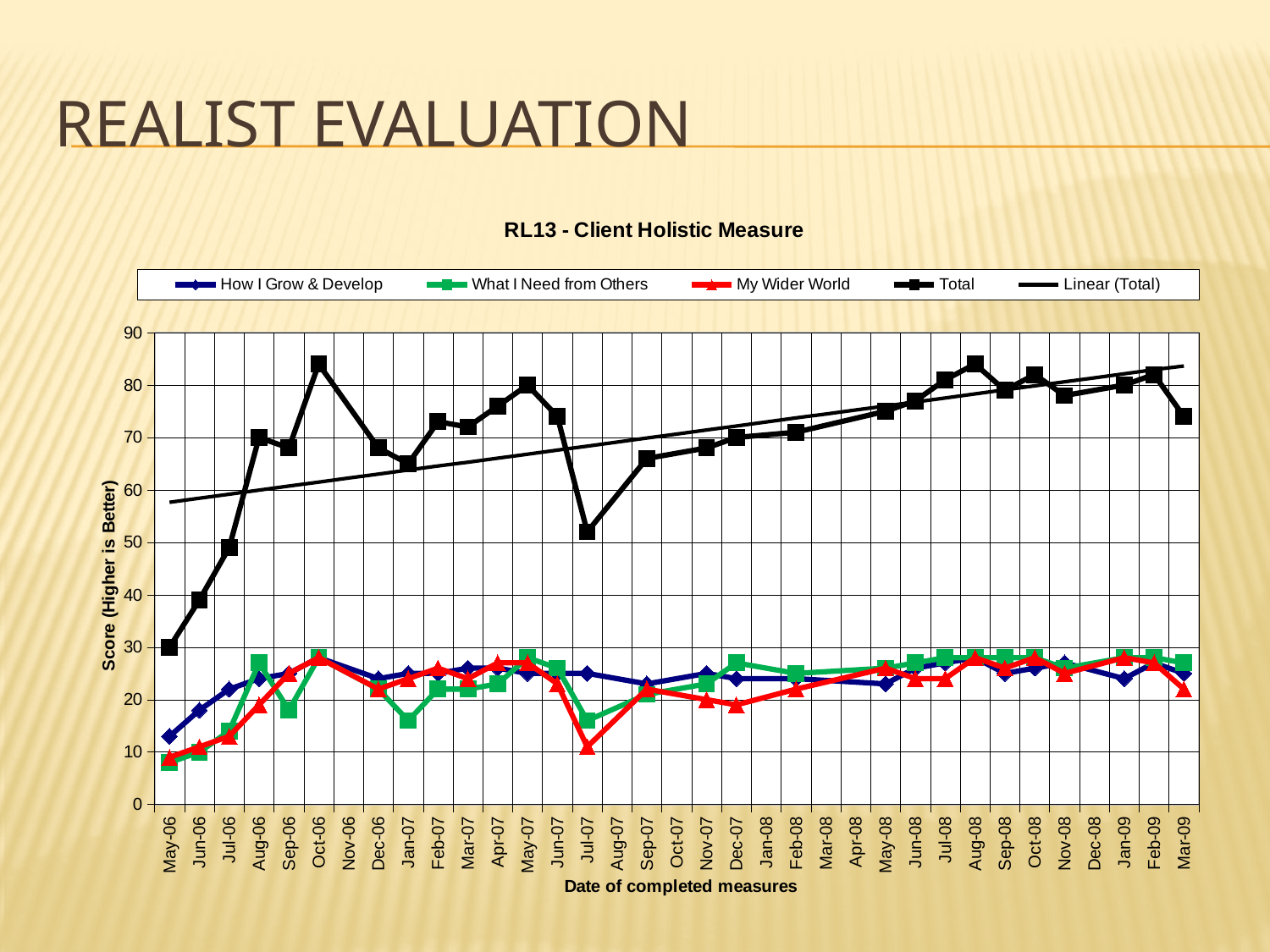
What is the label on the y axis? Score (Higher is Better) Is the Total value for Oct-06 greater or less than 80? greater Is the My Wider World value for Jul-07 greater or less than 20? less Is the Total value for Jul-07 greater or less than 60? less What kind of chart is shown on the slide? line chart What is the title of the chart? RL13 - Client Holistic Measure Which is larger for the Total series: the value at Oct-06 or the value at Jul-07? Oct-06 How many dates are shown along the x axis? 35 At which date is the Total series at its lowest? May-06 How many series does the legend list? 5 Does the Total series generally rise or fall from May-06 to Mar-09? rise